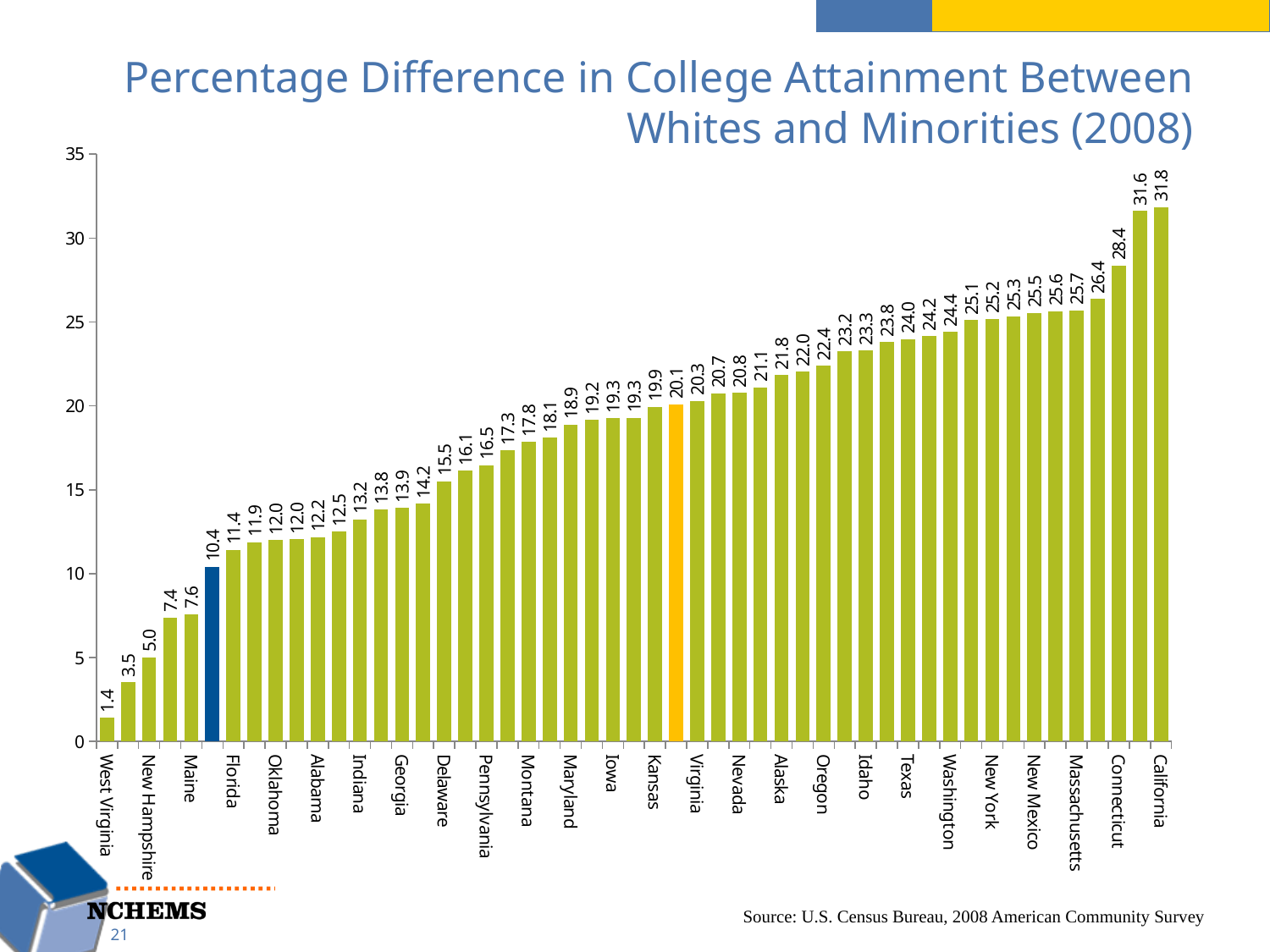
Which state has the lowest value? West Virginia Do the values rise or fall from left to right along the x axis? Rise What is the value for Connecticut? 28.4 Which has a larger value, Texas or Florida? Texas Is the value for Massachusetts greater or less than 25? greater What is the title of the chart? Percentage Difference in College Attainment Between Whites and Minorities (2008) What kind of chart is shown? Bar chart Which state has the highest value? California What is the value for Texas? 24.0 What is the difference between the values for California and West Virginia? 30.4 What is the value for California? 31.8 What is the value for West Virginia? 1.4